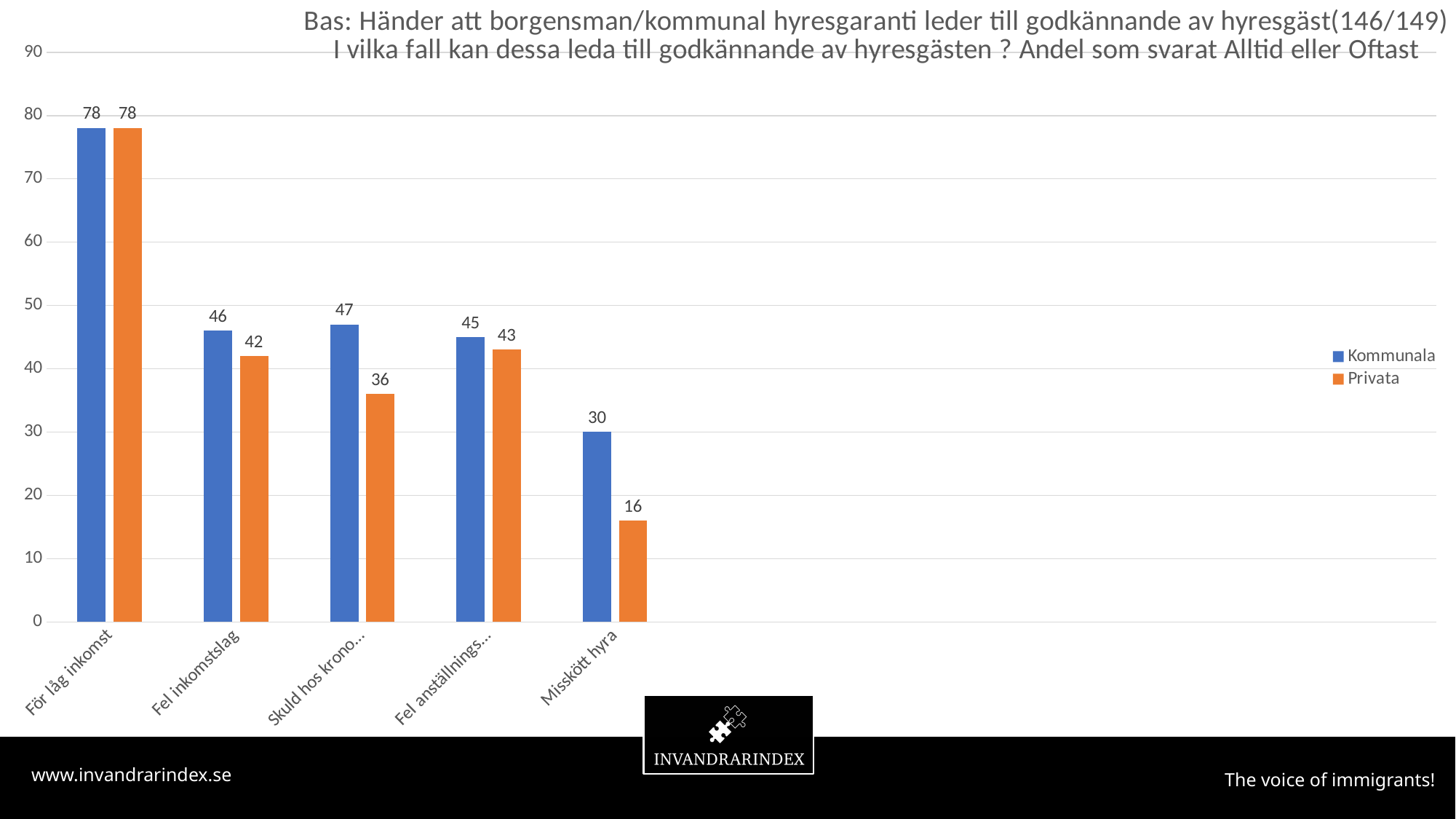
Which category has the lowest Privata value? Misskött hyra How many categories are shown on the x axis? 5 For the third category (Skuld hos krono...), which series has the larger value, Kommunala or Privata? Kommunala What is the Kommunala value for För låg inkomst? 78 What is the Privata value for Misskött hyra? 16 How many series does the legend list? 2 What kind of chart is shown on the slide? Bar chart What is the Kommunala value for the third category (Skuld hos krono...)? 47 What is the difference between the Kommunala and Privata values for Misskött hyra? 14 Which category has the highest Kommunala value? För låg inkomst What is the Privata value for Fel inkomstslag? 42 Which colour represents the Privata series? Orange